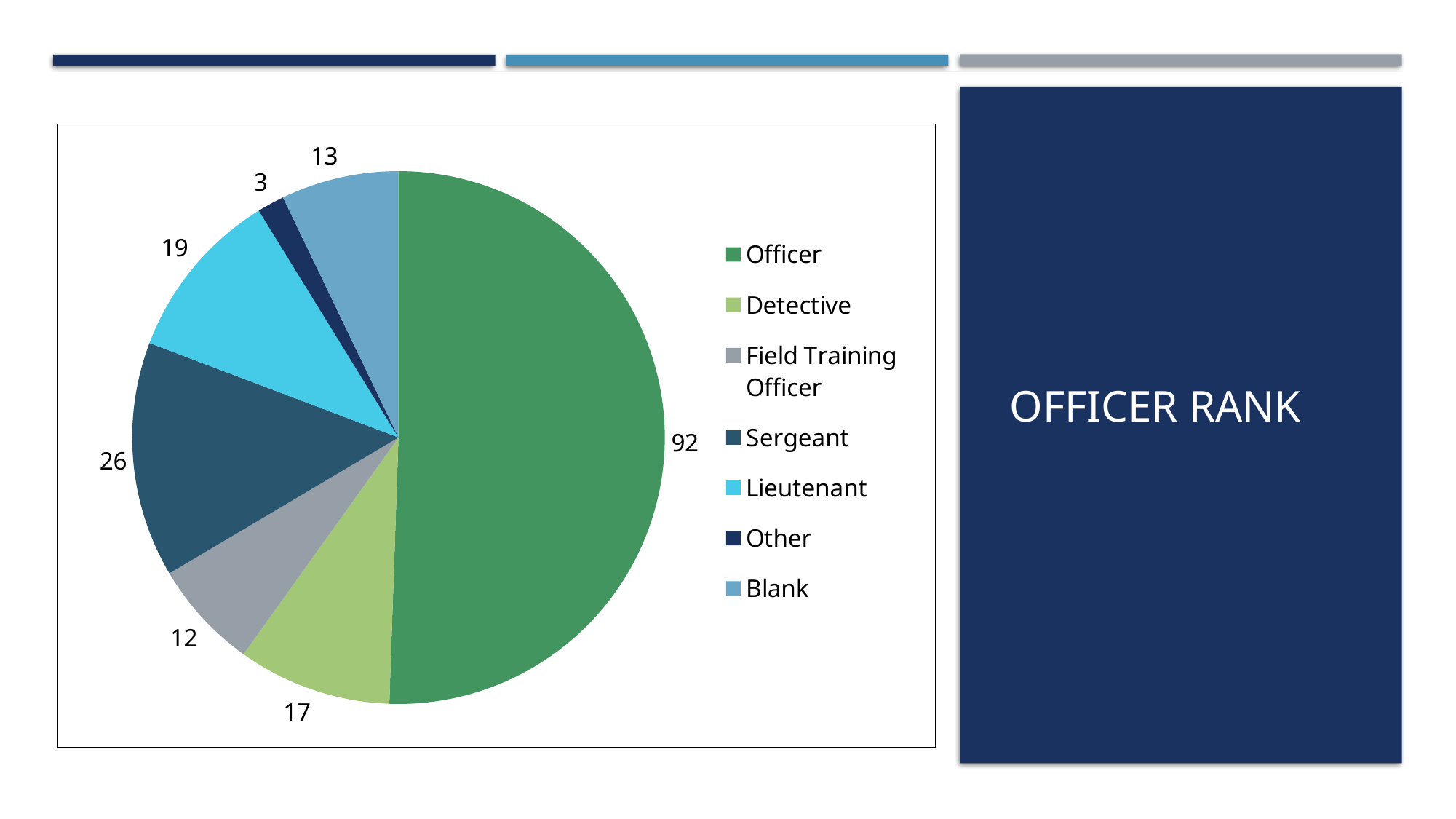
Which category has the smallest slice in the pie chart? Other What type of chart is shown on the slide? Pie chart What is the value for Officer in the pie chart? 92 What is the value for Blank in the pie chart? 13 What is the title shown in the panel to the right of the chart? OFFICER RANK How many categories does the pie chart show? 7 What is the value for Sergeant in the pie chart? 26 Which is larger, the value for Detective or the value for Blank? Detective What is the difference between the values for Sergeant and Lieutenant? 7 What is the value for Field Training Officer in the pie chart? 12 What is the total of all the slices in the pie chart? 182 Which category has the largest slice in the pie chart? Officer